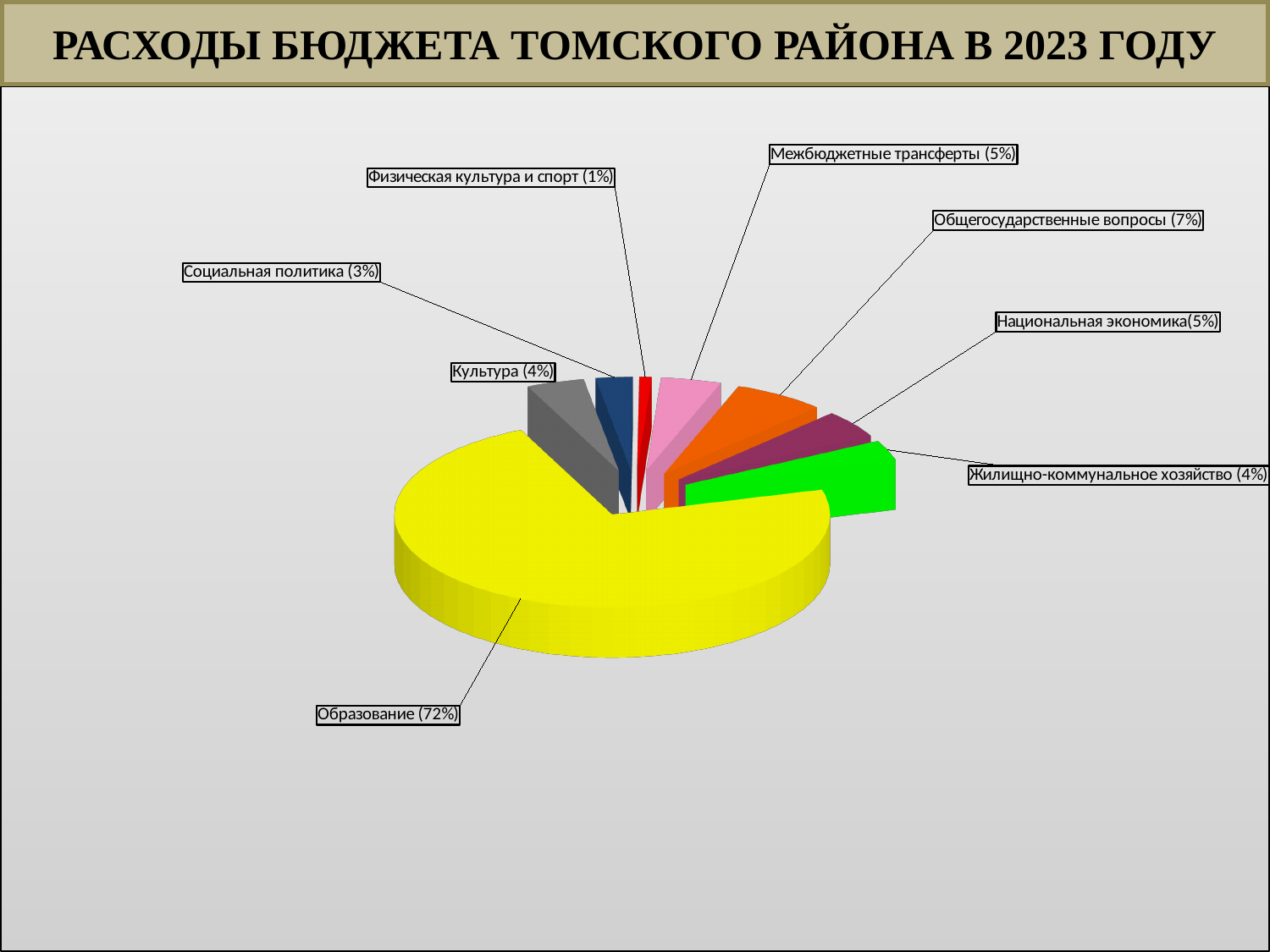
How many slices does the pie chart have? 8 What kind of chart is shown on the slide? Pie chart What is the title of the slide? РАСХОДЫ БЮДЖЕТА ТОМСКОГО РАЙОНА В 2023 ГОДУ What share of the pie does Общегосударственные вопросы have? 7% What share of the pie does Образование have? 72% What share of the pie does Межбюджетные трансферты have? 5% Which is larger, the share for Культура or the share for Общегосударственные вопросы? Общегосударственные вопросы Which category has the smallest slice of the pie? Физическая культура и спорт What is the difference in percentage points between Образование and Общегосударственные вопросы? 65 Which category has the largest slice of the pie? Образование